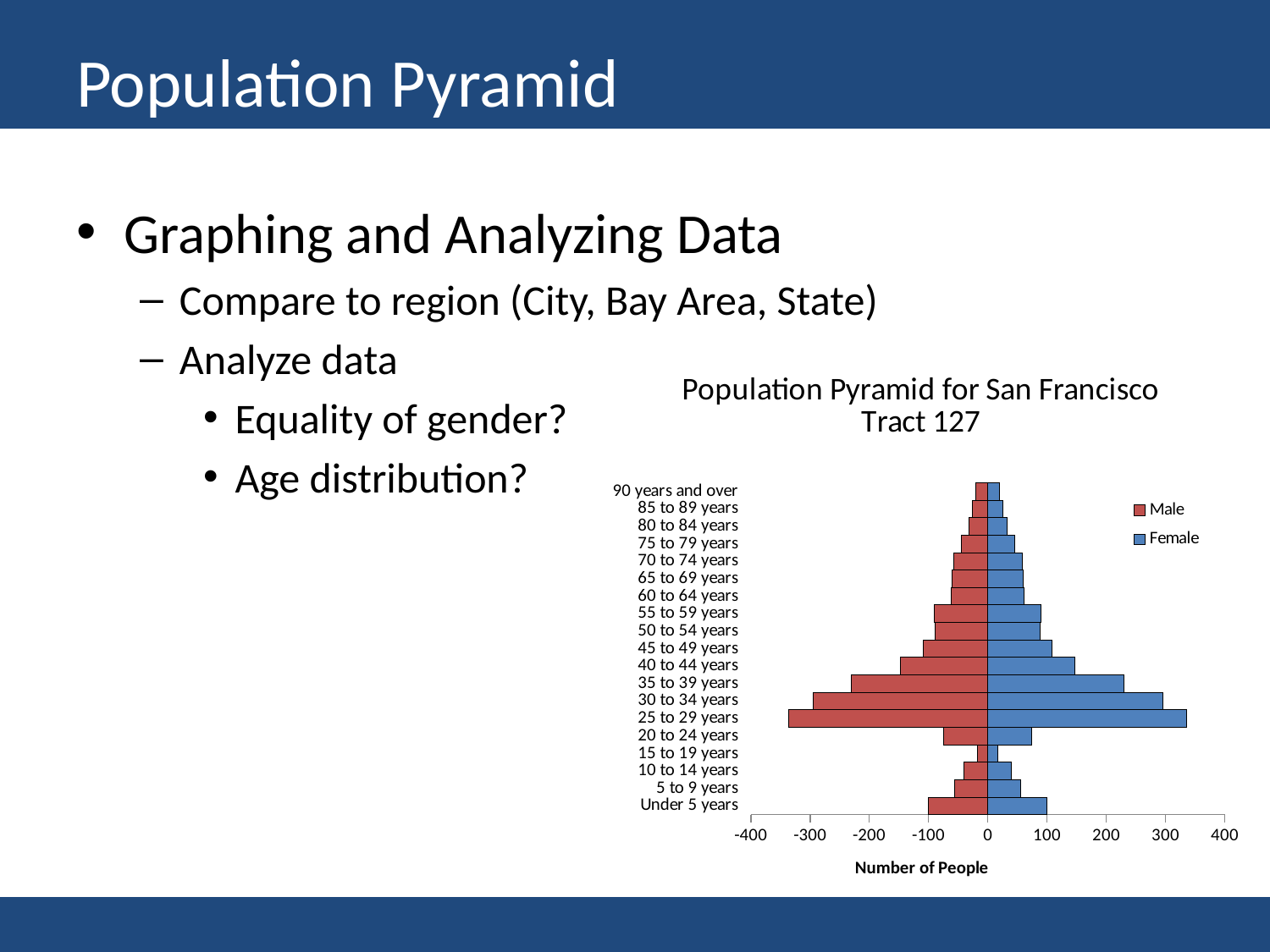
What is the label of the horizontal axis? Number of People What kind of chart is shown on the slide? bar chart Which age group has the largest Female bar? 25 to 29 years Is the Female value for Under 5 years greater or less than 50? greater How many series does the chart's legend list? 2 How many age-group categories are plotted on the chart? 19 Is the Female value for 25 to 29 years greater or less than 300? greater Which age group has the smallest Female bar? 15 to 19 years Which age group has the longest Male bar? 25 to 29 years Which is larger, the Female value for 30 to 34 years or the Female value for 40 to 44 years? 30 to 34 years Is the Female value for 35 to 39 years greater or less than 300? less What is the title of the chart? Population Pyramid for San Francisco Tract 127